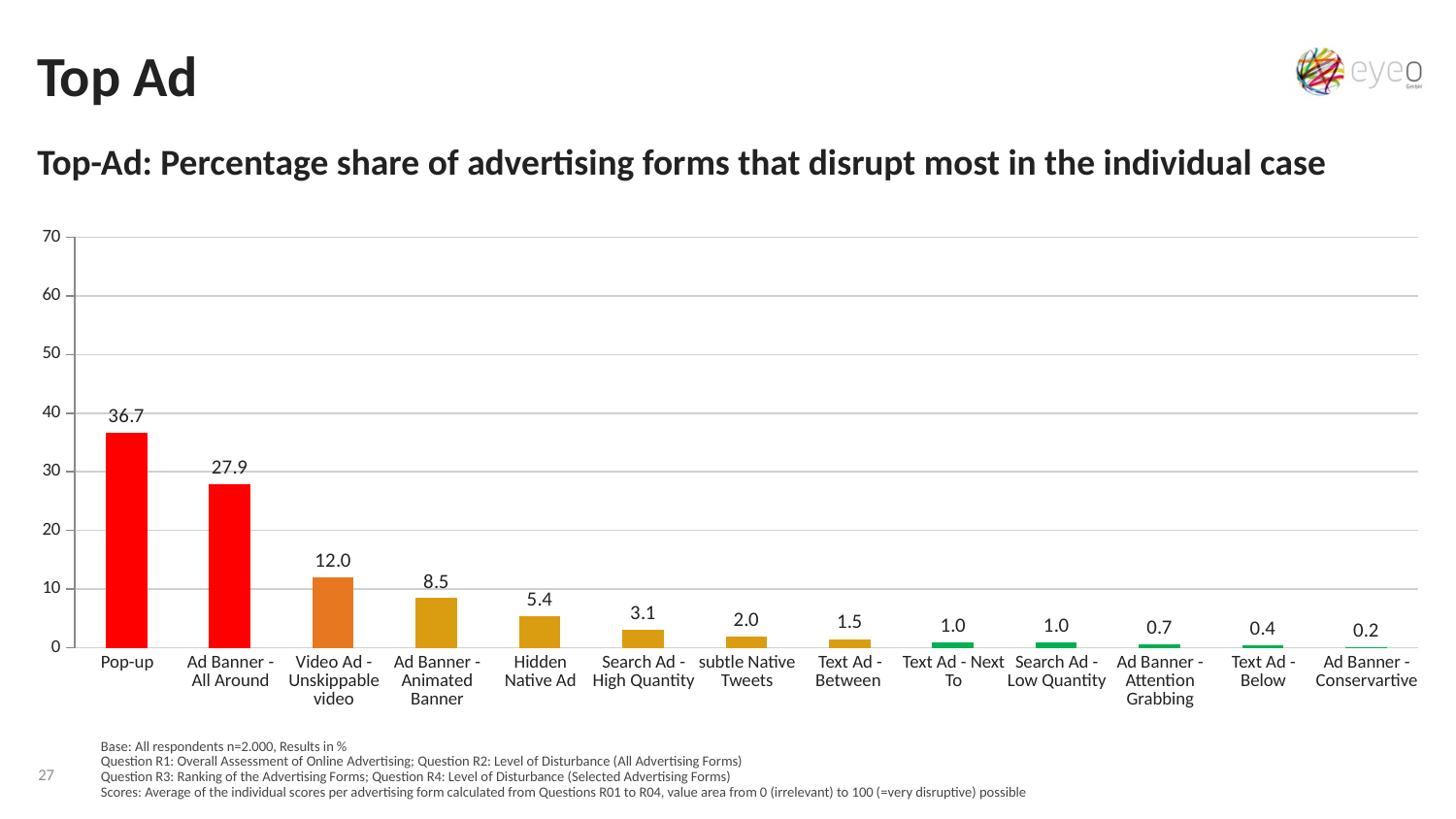
What is the difference between the values for Pop-up and Ad Banner - All Around? 8.8 How many advertising forms are shown on the x axis? 13 What kind of chart is shown on the slide? Bar chart Which is larger, the value for Ad Banner - Animated Banner or the value for Search Ad - High Quantity? Ad Banner - Animated Banner What is the value for Video Ad - Unskippable video? 12.0 Which advertising form has the highest value? Pop-up Which advertising form has the lowest value? Ad Banner - Conservartive What is the value for Hidden Native Ad? 5.4 What is the value for Pop-up? 36.7 What is the title of the chart? Top-Ad: Percentage share of advertising forms that disrupt most in the individual case Is the value for Ad Banner - All Around greater or less than 20? greater Do the values rise or fall from left to right along the x axis? Fall